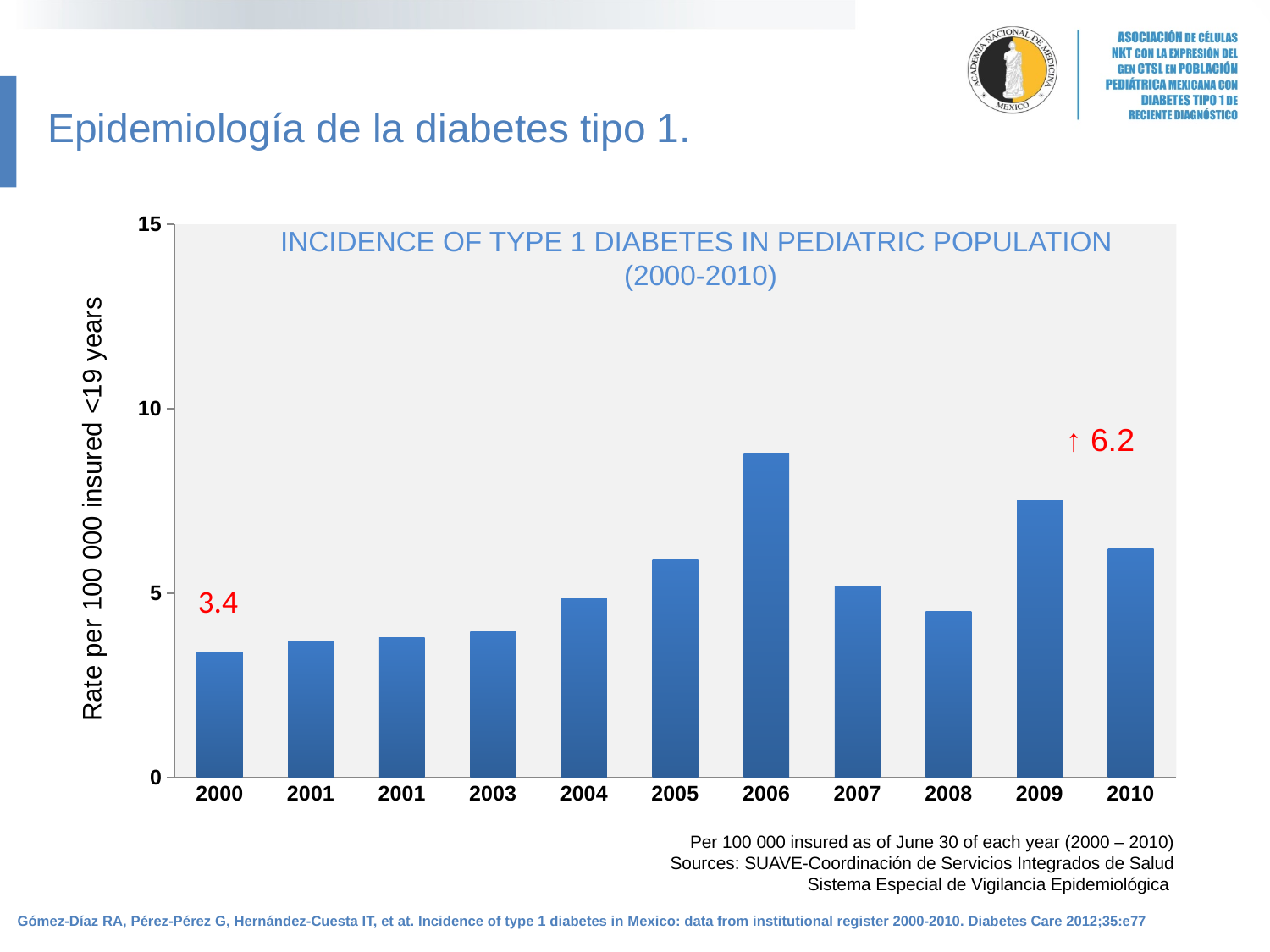
What is the value for 2000 in the chart? 3.4 Is the value for 2009 greater or less than 10? less Is the value for 2006 greater or less than 5? greater Which is larger, the value for 2009 or the value for 2010? 2009 Which year has the lowest incidence rate in the chart? 2000 How many bars are plotted in the chart? 11 Which year has the highest incidence rate in the chart? 2006 What is the difference between the values for 2010 and 2000? 2.8 What kind of chart is shown on the slide? Bar chart What is the value for 2010 in the chart? 6.2 What is the title of the chart? INCIDENCE OF TYPE 1 DIABETES IN PEDIATRIC POPULATION (2000-2010)